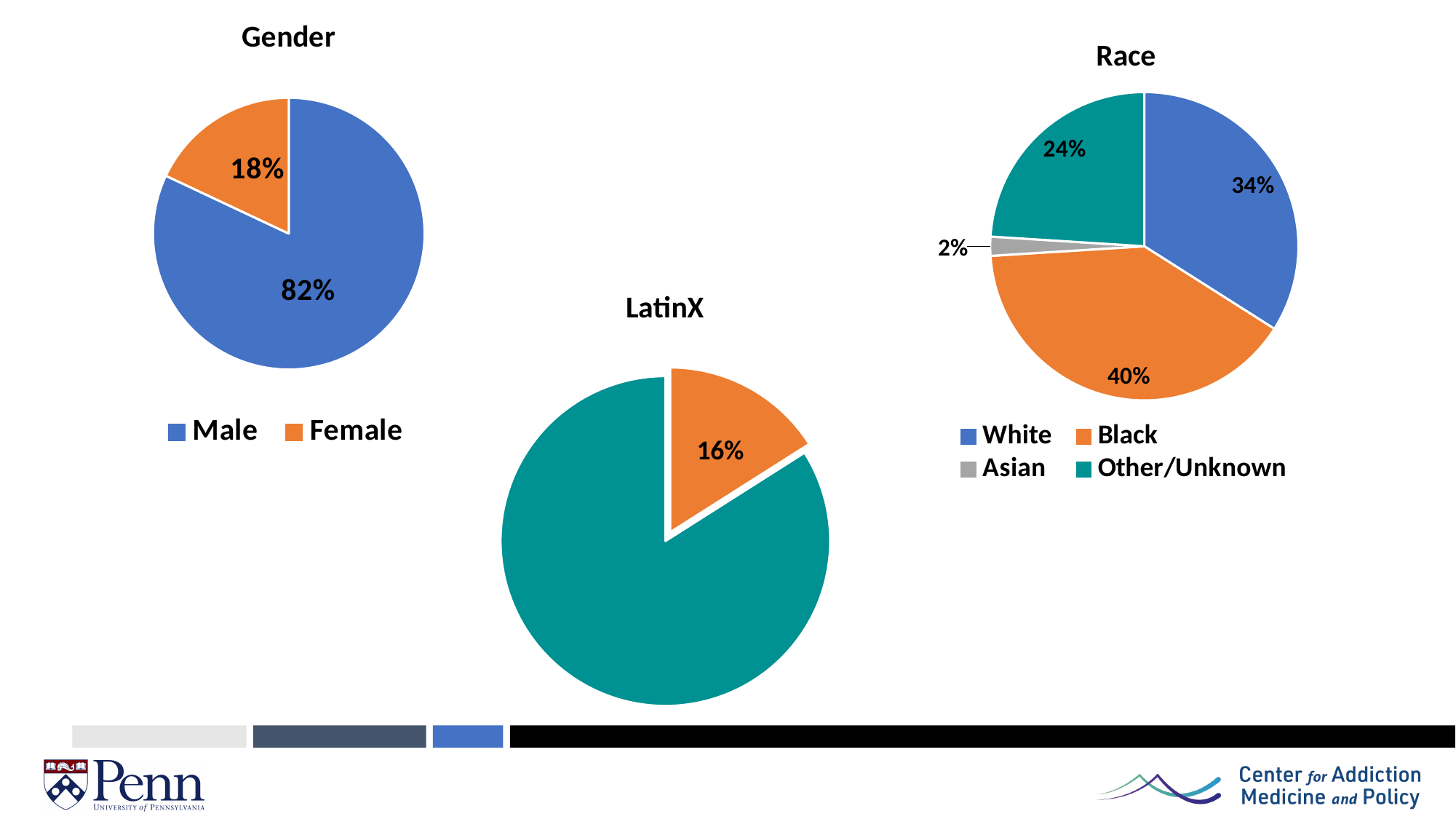
In the Race chart, what is the difference between the Black and White shares? 6% What kind of chart is the LatinX chart? Pie chart In the Race chart, what percentage is Other/Unknown? 24% In the Race chart, which category has the largest share? Black In the Gender chart, what percentage is Female? 18% In the Gender chart, which category has the larger share? Male In the Race chart, which category has the smallest share? Asian In the Gender chart, what is the difference between the Male and Female shares? 64% In the Gender chart, what percentage is Male? 82% How many categories does the Race chart's legend list? 4 In the Race chart, which is larger, White or Other/Unknown? White In the Race chart, what percentage is Black? 40%